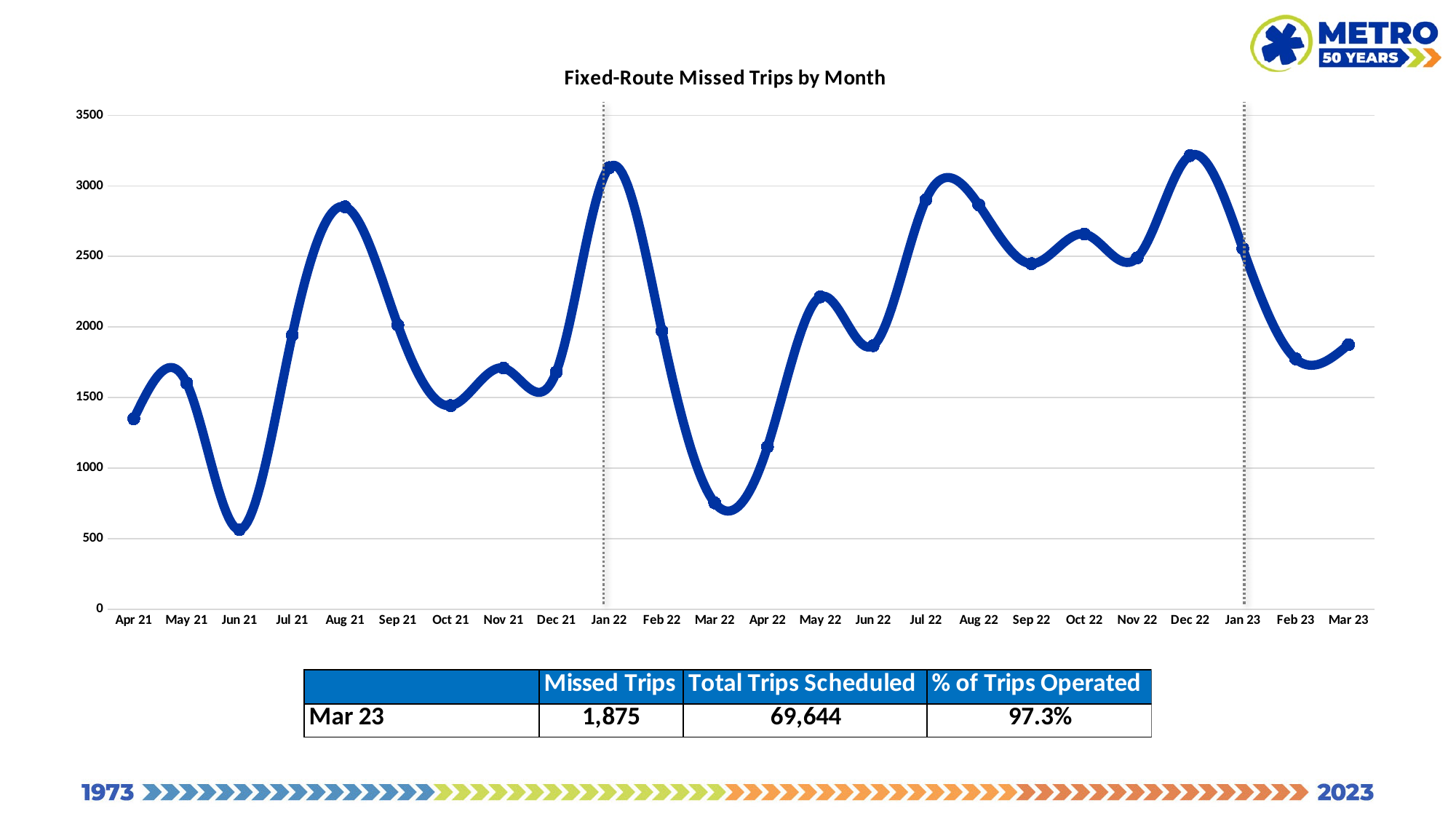
Is the value for Aug 21 greater or less than 2500? greater What kind of chart is shown on the slide? line chart What is the title of the chart? Fixed-Route Missed Trips by Month Is the value for Dec 22 greater or less than 3000? greater Is the value for Jun 21 greater or less than 1000? less Do the values rise or fall from Dec 22 to Feb 23? fall Which has more missed trips, Jan 22 or Feb 22? Jan 22 How many missed trips are shown for Mar 23? 1,875 Which month has the lowest number of missed trips on the chart? Jun 21 How many months are plotted on the x axis of the chart? 24 Which has more missed trips, Mar 22 or Jul 22? Jul 22